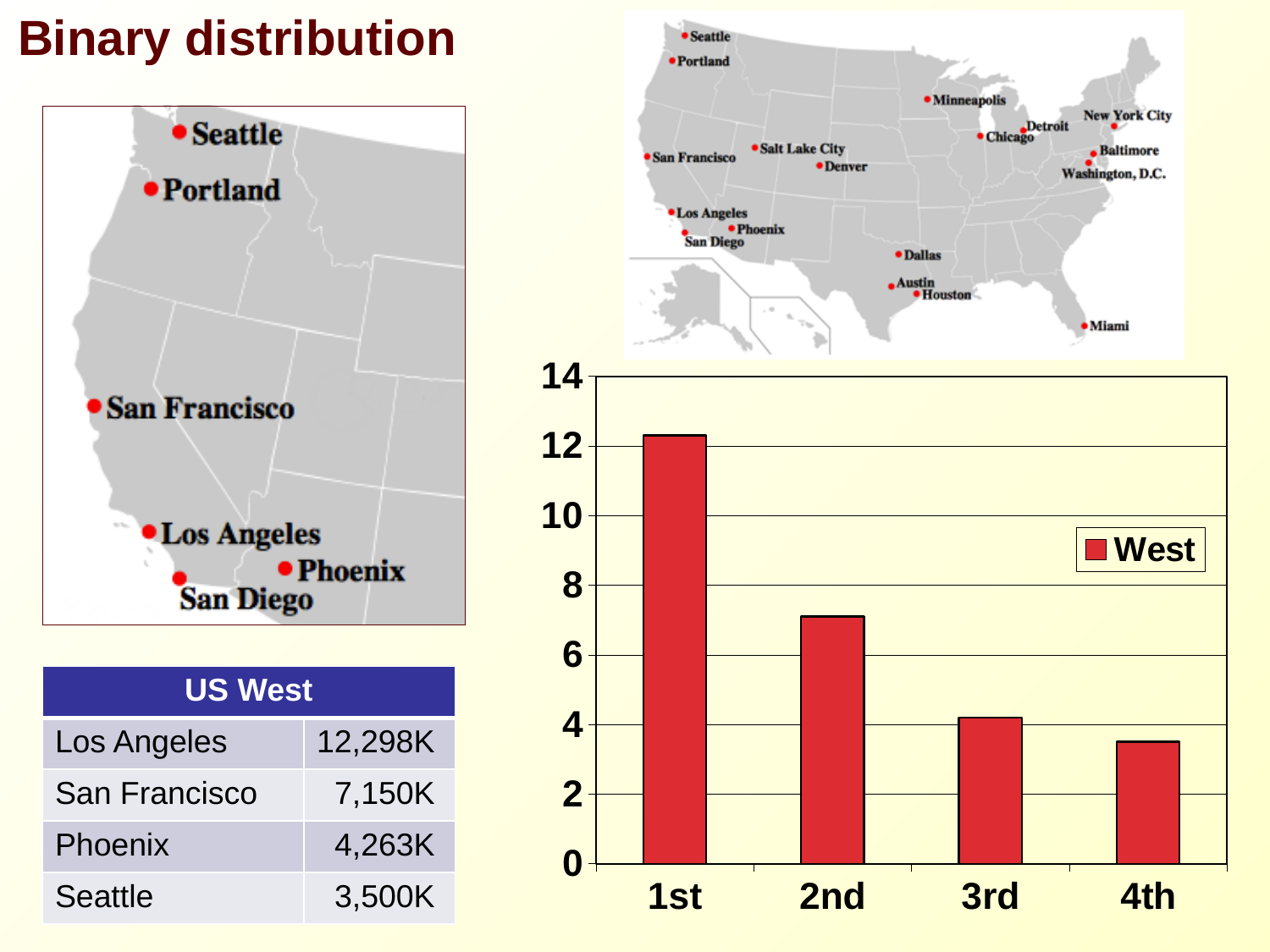
Is the value for 3rd greater or less than 6? less What kind of chart is shown on the slide? bar chart Which is larger in the chart, the value for 2nd or the value for 3rd? 2nd Is the value for 4th greater or less than 2? greater How many categories are shown on the x axis of the bar chart? 4 Do the bar values rise or fall from 1st to 4th along the x axis? fall Which category has the lowest bar in the chart? 4th How many series does the legend of the bar chart list? 1 Is the value for 1st greater or less than 10? greater What series name is shown in the legend of the bar chart? West Which category has the highest bar in the chart? 1st